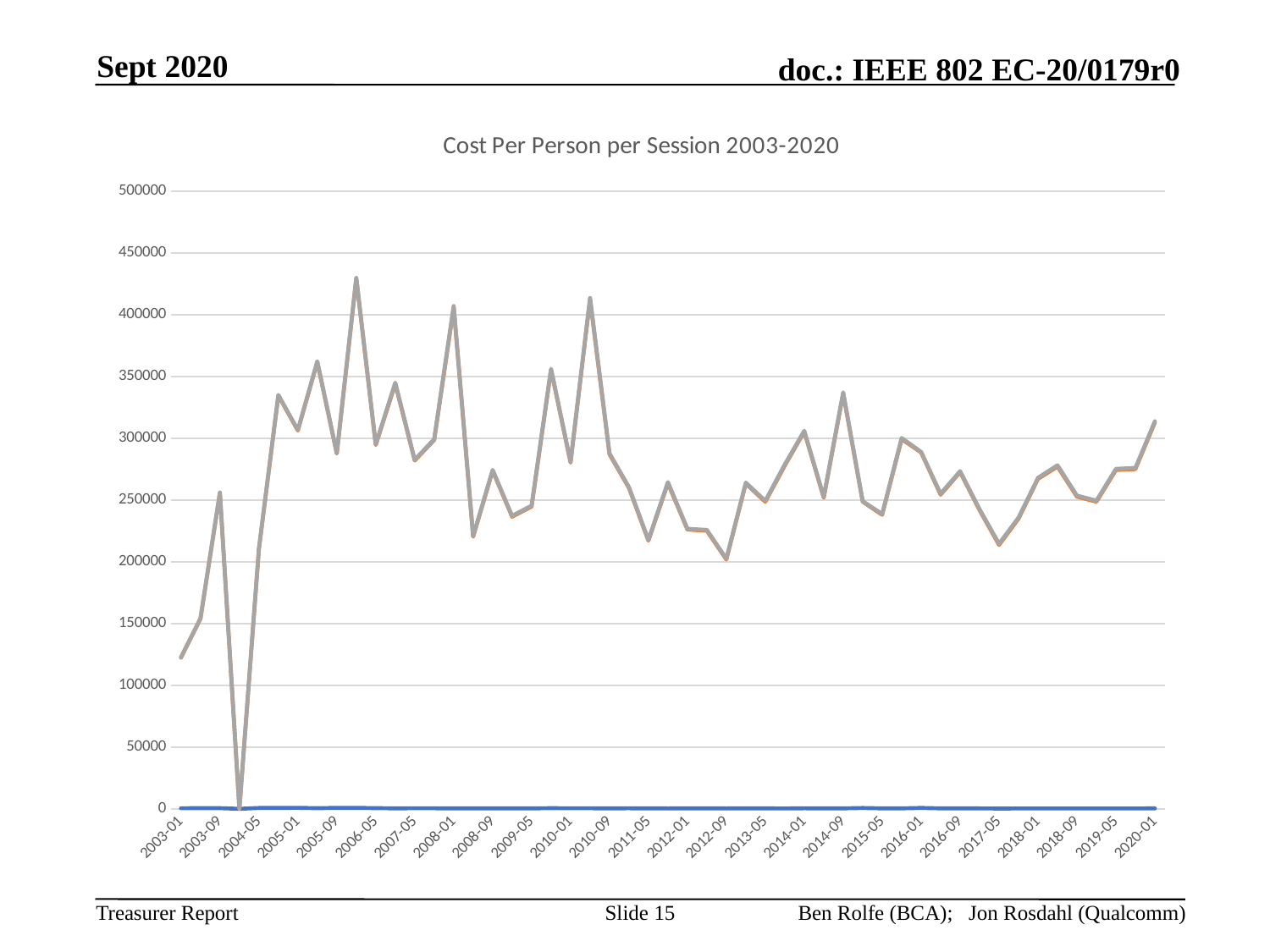
Is the value for 2003-01 greater or less than 150000? less What is the highest value shown on the vertical axis of the chart? 500000 Is the value for 2005-01 greater or less than 300000? greater Is the value for 2020-01 greater or less than 300000? greater Which has the higher cost per person, 2008-01 or 2012-09? 2008-01 What is the title of the chart? Cost Per Person per Session 2003-2020 What type of chart is shown on the slide? Line chart Which has the higher cost per person, 2005-01 or 2003-01? 2005-01 Does the cost per person rise or fall between 2017-05 and 2020-01? Rise